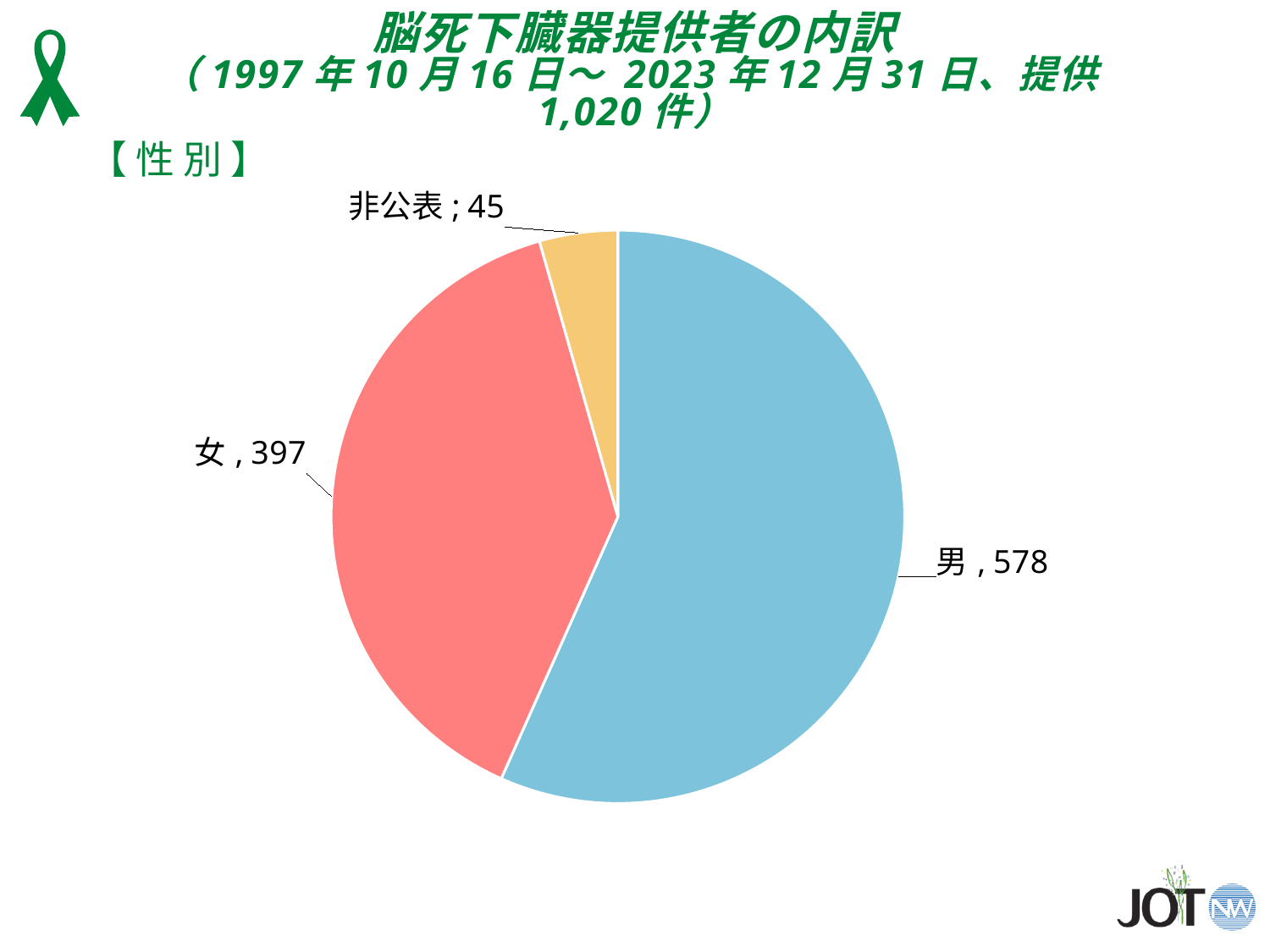
What colour is the slice for 男 in the pie chart? light blue How many slices does the pie chart have? 3 What is the total of all slices in the pie chart? 1,020 What type of chart is shown on the slide? pie chart Which category has the smallest slice in the pie chart? 非公表 What is the value for 男 in the pie chart? 578 What is the difference between the values for 男 and 女? 181 Which is larger, the value for 女 or the value for 非公表? 女 What is the value for 非公表 in the pie chart? 45 What is the difference between the values for 女 and 非公表? 352 Which category has the largest slice in the pie chart? 男 What is the value for 女 in the pie chart? 397